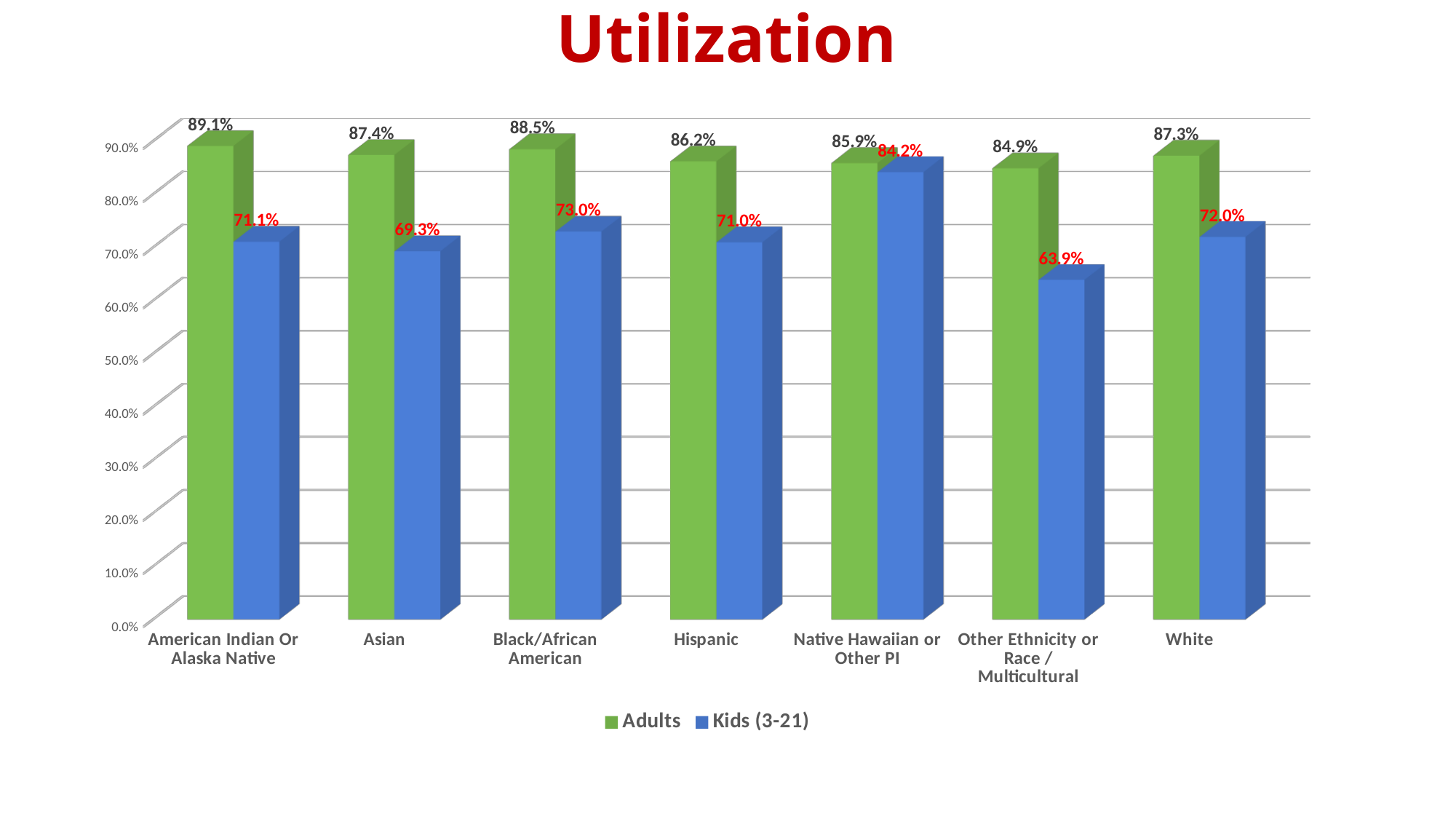
What is the Kids (3-21) value for Native Hawaiian or Other PI? 84.2% Which category has the lowest Kids (3-21) value? Other Ethnicity or Race / Multicultural How many categories are shown on the x axis? 7 What kind of chart is shown on the slide? bar chart Which category has the highest Adults value? American Indian Or Alaska Native What is the title of the chart? Utilization How many series does the legend list? 2 What is the Kids (3-21) utilization value for Black/African American? 73.0% Is the Kids (3-21) value for Other Ethnicity or Race / Multicultural greater or less than 70.0%? less What is the difference between the Adults and Kids (3-21) values for White? 15.3% Which is larger, the Kids (3-21) value for Asian or the Kids (3-21) value for Hispanic? Hispanic What is the Adults utilization value for Hispanic? 86.2%